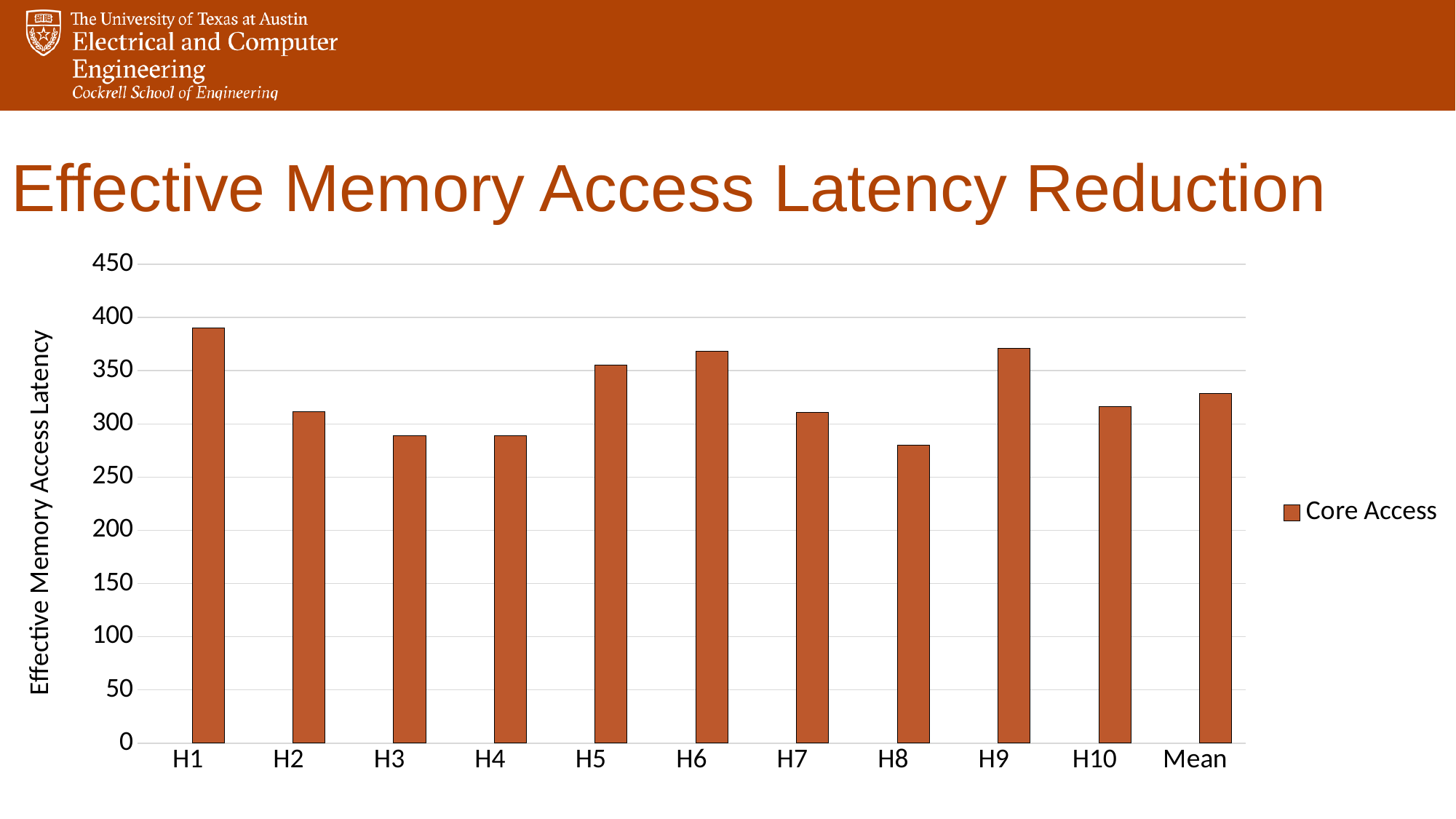
How many series does the legend list? 1 Is the value for Mean greater or less than 300? greater Which category has the lowest Effective Memory Access Latency? H8 Which is larger, the value for H1 or the value for H9? H1 What kind of chart is shown on the slide? bar chart How many categories are plotted along the x axis? 11 What is the name of the series shown in the legend? Core Access Is the value for H1 greater or less than 350? greater Is the value for H8 greater or less than 300? less Which category has the highest Effective Memory Access Latency? H1 Which is larger, the value for H8 or the value for H10? H10